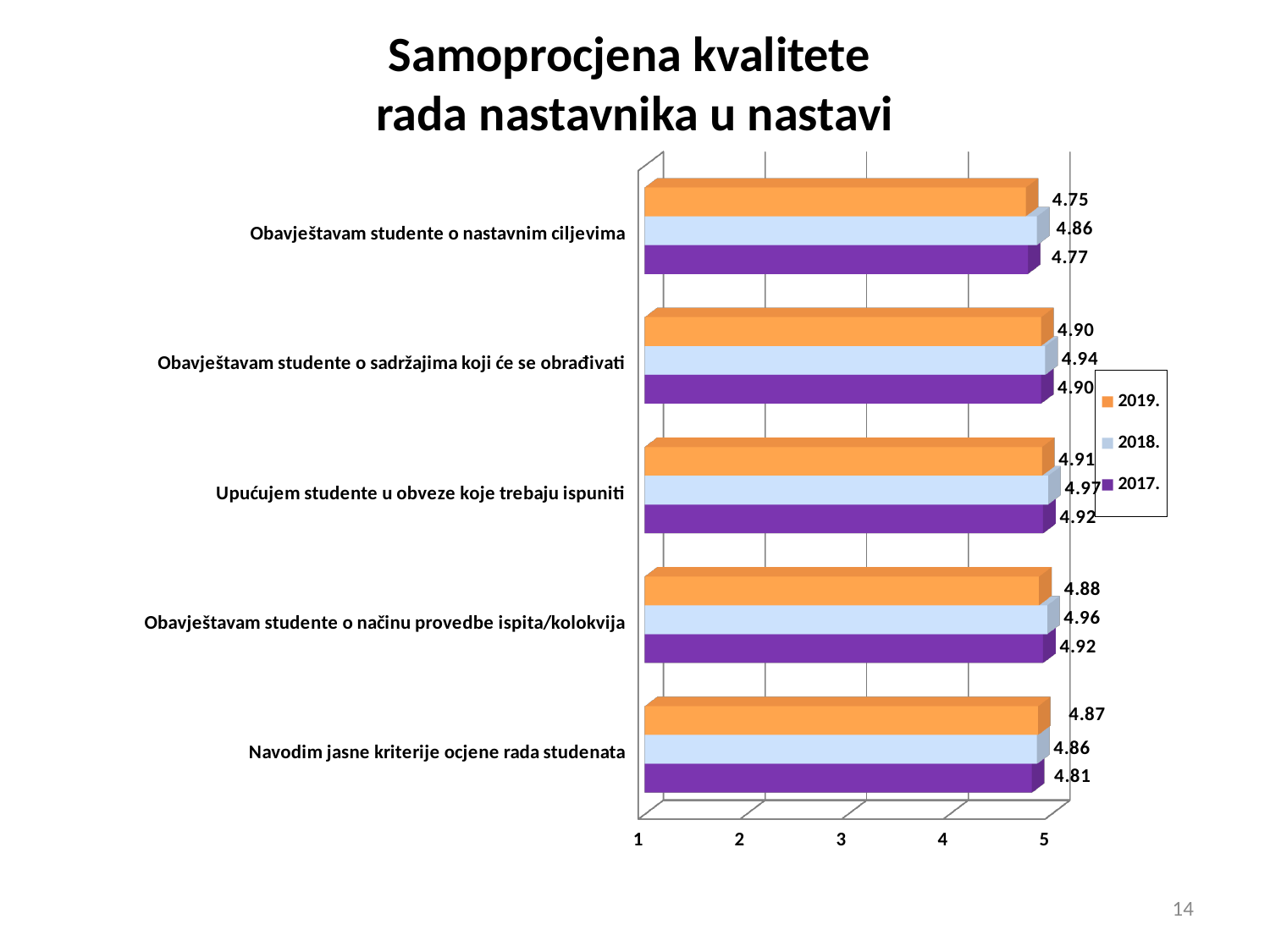
What is the 2018. value for "Obavještavam studente o načinu provedbe ispita/kolokvija"? 4.96 What is the difference between the 2018. and 2019. values for "Obavještavam studente o nastavnim ciljevima"? 0.11 What is the title of the chart on the slide? Samoprocjena kvalitete rada nastavnika u nastavi What is the 2018. value for "Upućujem studente u obveze koje trebaju ispuniti"? 4.97 How many categories are shown on the chart? 5 For "Navodim jasne kriterije ocjene rada studenata", which is larger: the 2019. value or the 2017. value? 2019. What is the 2019. value for "Obavještavam studente o nastavnim ciljevima"? 4.75 Which category has the highest 2018. value? Upućujem studente u obveze koje trebaju ispuniti What kind of chart is shown on the slide? Bar chart What is the 2017. value for "Navodim jasne kriterije ocjene rada studenata"? 4.81 How many series does the legend list? 3 Which category has the lowest 2019. value? Obavještavam studente o nastavnim ciljevima